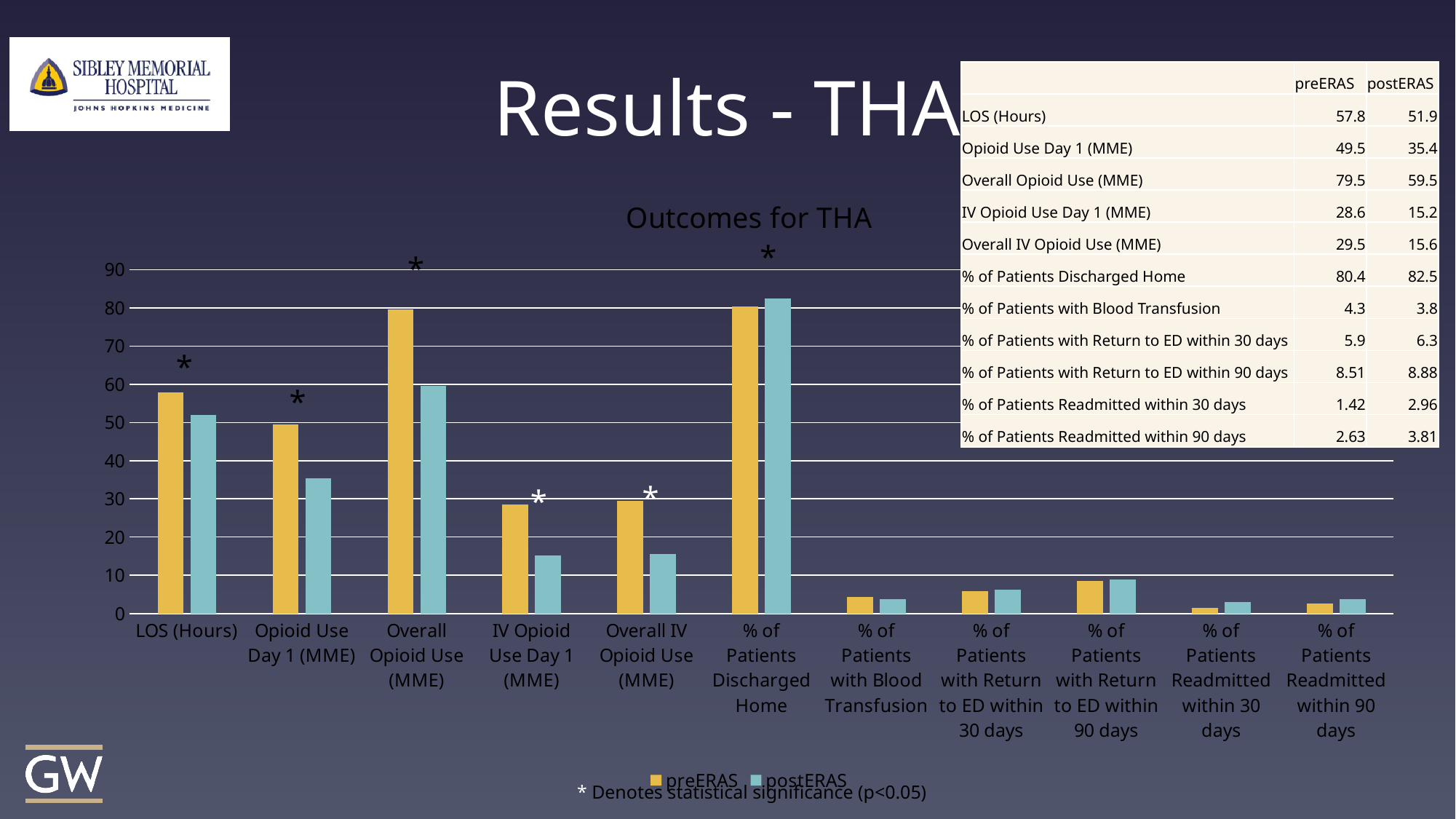
How many series does the chart legend list? 2 Is the preERAS value for Overall Opioid Use (MME) greater or less than 70? greater What type of chart is shown on the slide? bar chart Which category has the highest postERAS value? % of Patients Discharged Home Which colour represents the postERAS series in the chart? blue Which category has the lowest preERAS value? % of Patients Readmitted within 30 days How many categories are shown on the x axis of the chart? 11 What is the postERAS value for Overall Opioid Use (MME)? 59.5 Which is larger for Opioid Use Day 1 (MME), the preERAS value or the postERAS value? preERAS What is the preERAS value for LOS (Hours)? 57.8 What is the difference between the preERAS and postERAS values for IV Opioid Use Day 1 (MME)? 13.4 What is the title of the chart? Outcomes for THA